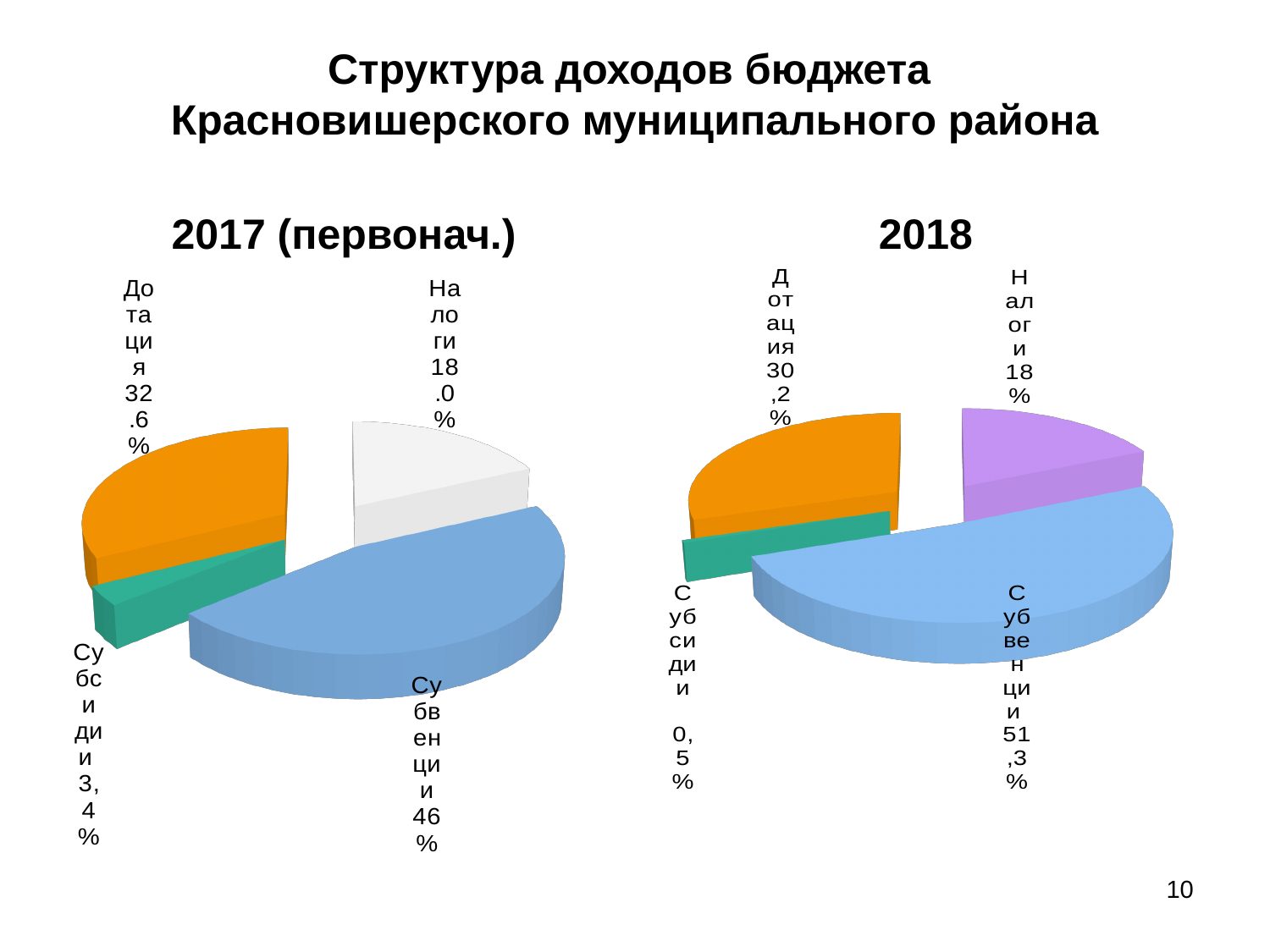
In the 2017 (первонач.) pie chart, what share is labelled for Субвенции? 46% In the 2018 pie chart, what share is labelled for Субсидии? 0,5% In the 2017 (первонач.) pie chart, which category has the smallest slice? Субсидии In the 2017 (первонач.) pie chart, what share is labelled for Дотация? 32.6% In the 2018 pie chart, what share is labelled for Субвенции? 51,3% In the 2018 pie chart, which category has the largest slice? Субвенции How many slices does the 2017 (первонач.) pie chart have? 4 In the 2017 (первонач.) pie chart, what share is labelled for Субсидии? 3,4% In the 2018 pie chart, what share is labelled for Дотация? 30,2% What is the title of the slide containing the two charts? Структура доходов бюджета Красновишерского муниципального района What type of chart is used for the 2018 data? Pie chart In the 2018 pie chart, which is larger: Дотация or Налоги? Дотация